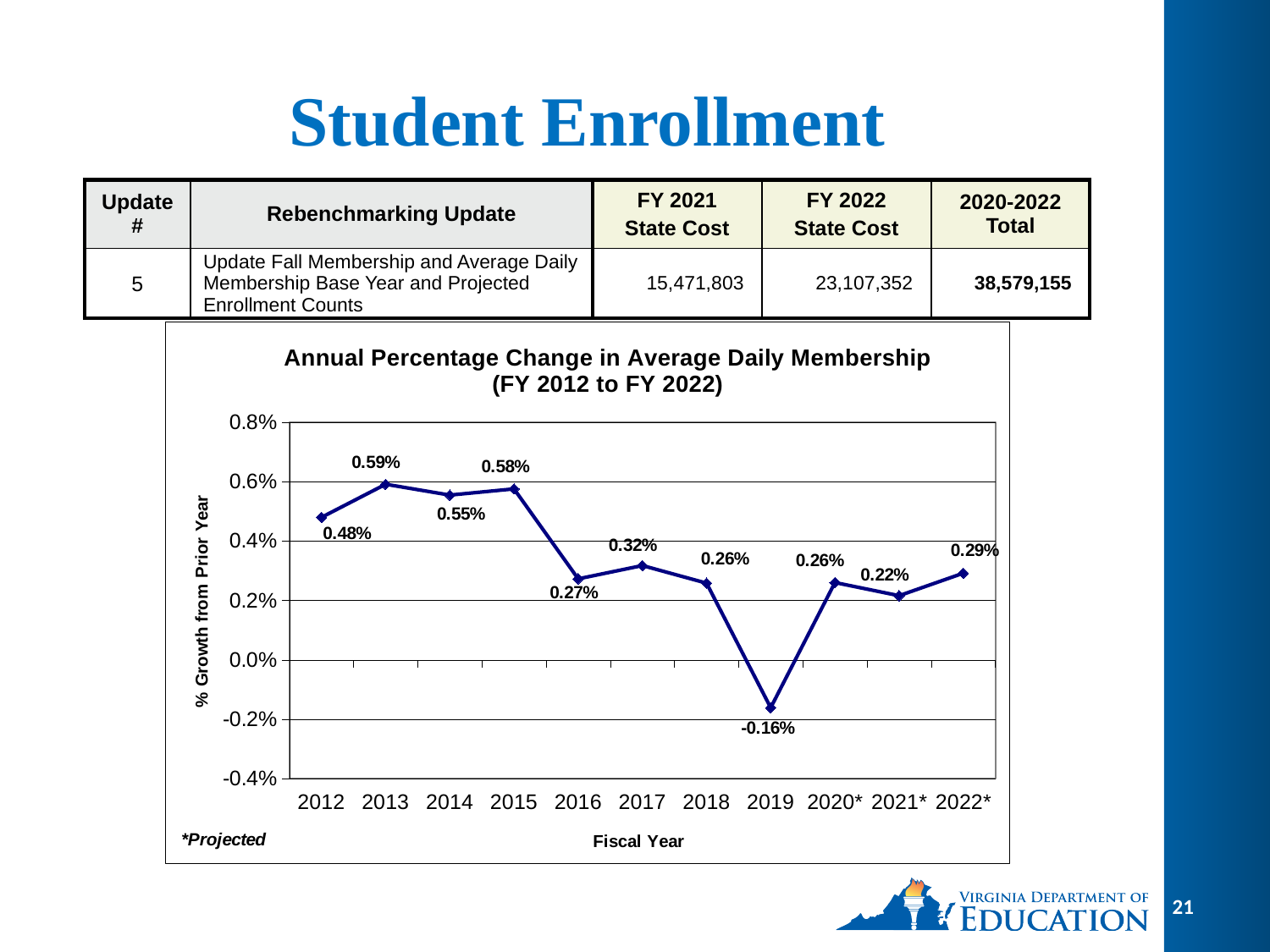
What is the annual percentage change in average daily membership for fiscal year 2019? -0.16% What is the difference between the annual percentage change for fiscal year 2015 and fiscal year 2016? 0.31% What is the title of the chart? Annual Percentage Change in Average Daily Membership (FY 2012 to FY 2022) What kind of chart is shown on the slide? Line chart Which fiscal year has a larger annual percentage change, 2012 or 2017? 2012 How many fiscal years are plotted on the chart? 11 What is the projected annual percentage change in average daily membership for fiscal year 2022? 0.29% Which fiscal year has the highest annual percentage change in average daily membership? 2013 Which fiscal year has the lowest annual percentage change in average daily membership? 2019 Does the annual percentage change generally rise or fall from fiscal year 2013 to fiscal year 2019? Fall What is the annual percentage change in average daily membership for fiscal year 2013? 0.59% Is the value for fiscal year 2014 greater or less than 0.4%? greater